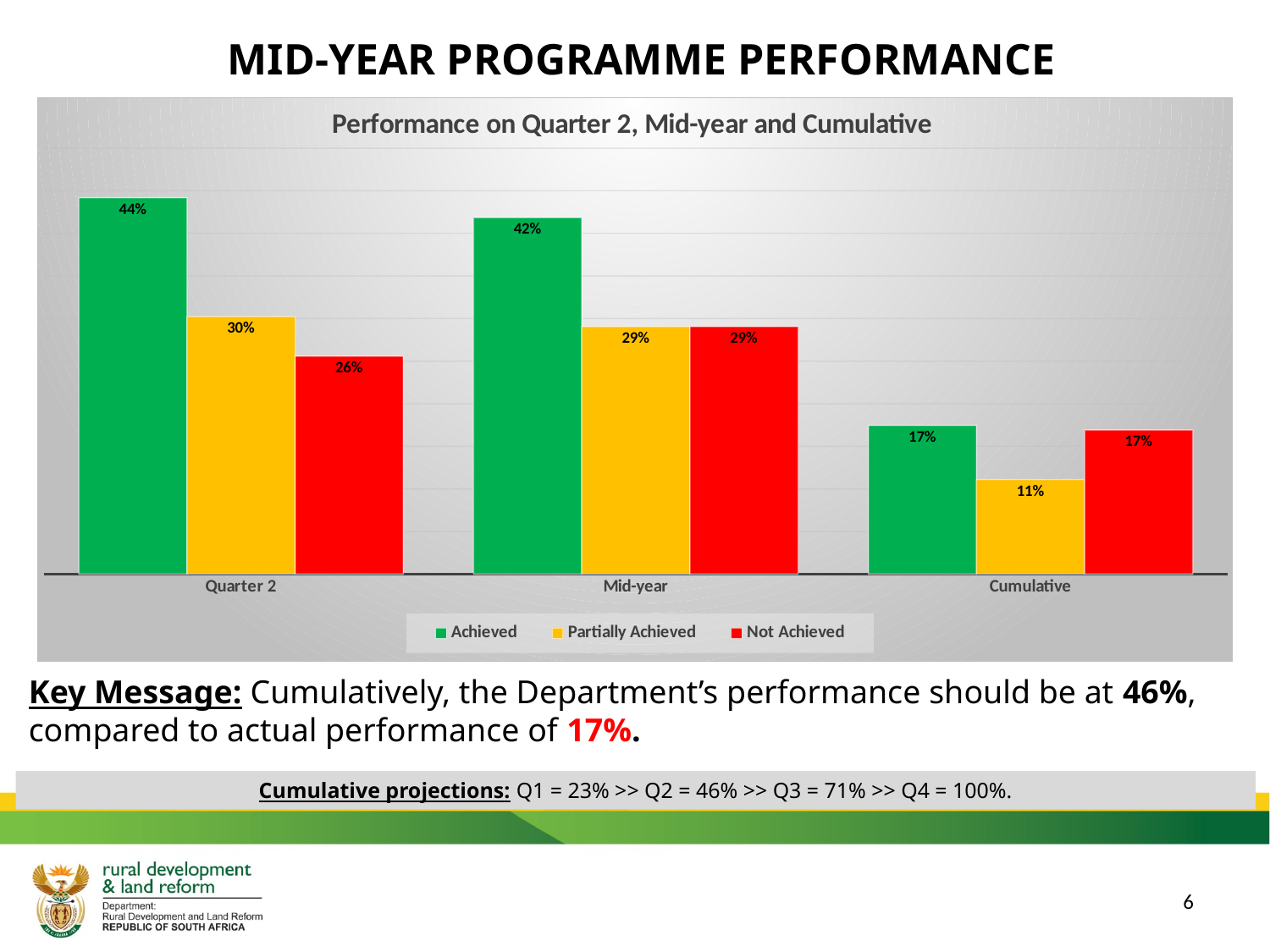
What is the Achieved value for Quarter 2? 44% Which category has the highest Achieved value? Quarter 2 What is the title of the chart? Performance on Quarter 2, Mid-year and Cumulative What is the difference between the Achieved values for Quarter 2 and Mid-year? 2% How many categories are shown on the x axis? 3 How many series does the legend list? 3 What is the Partially Achieved value for Cumulative? 11% What is the Not Achieved value for Cumulative? 17% What is the Partially Achieved value for Mid-year? 29% Which is larger: the Not Achieved value for Quarter 2 or the Not Achieved value for Mid-year? Mid-year Which category has the lowest Partially Achieved value? Cumulative What kind of chart is shown? Bar chart